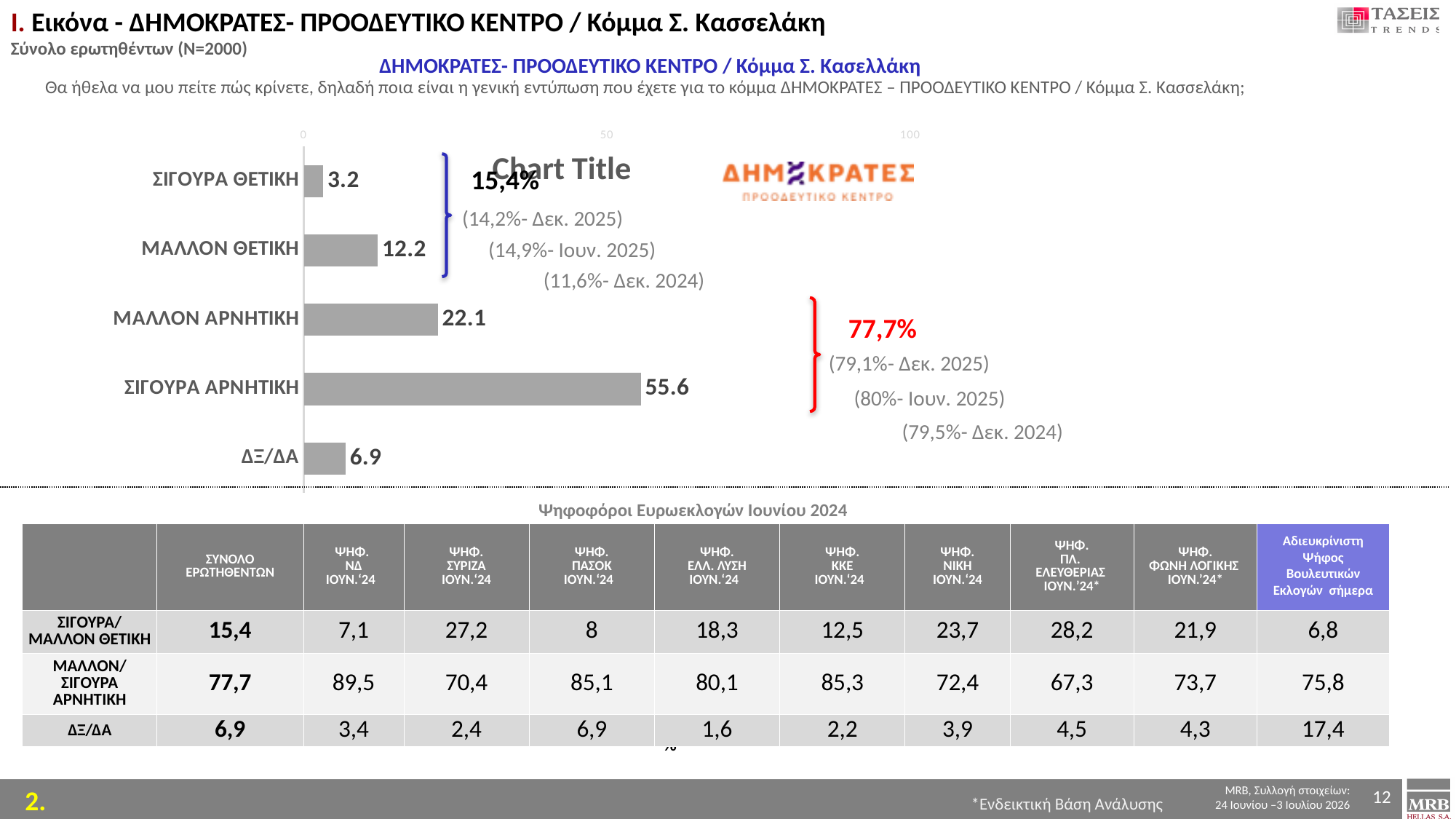
What is the value for ΔΞ/ΔΑ? 6.9 Which is larger, the value for ΜΑΛΛΟΝ ΘΕΤΙΚΗ or the value for ΔΞ/ΔΑ? ΜΑΛΛΟΝ ΘΕΤΙΚΗ What is the value for ΣΙΓΟΥΡΑ ΘΕΤΙΚΗ? 3.2 What is the value for ΜΑΛΛΟΝ ΘΕΤΙΚΗ? 12.2 Is the value for ΣΙΓΟΥΡΑ ΑΡΝΗΤΙΚΗ greater or less than 50? greater What is the difference between the values for ΜΑΛΛΟΝ ΘΕΤΙΚΗ and ΣΙΓΟΥΡΑ ΘΕΤΙΚΗ? 9.0 What is the difference between the values for ΣΙΓΟΥΡΑ ΑΡΝΗΤΙΚΗ and ΜΑΛΛΟΝ ΑΡΝΗΤΙΚΗ? 33.5 What kind of chart is shown on the slide? bar chart How many categories are shown in the bar chart? 5 What is the value for ΣΙΓΟΥΡΑ ΑΡΝΗΤΙΚΗ? 55.6 Which category has the highest value? ΣΙΓΟΥΡΑ ΑΡΝΗΤΙΚΗ Which category has the lowest value? ΣΙΓΟΥΡΑ ΘΕΤΙΚΗ